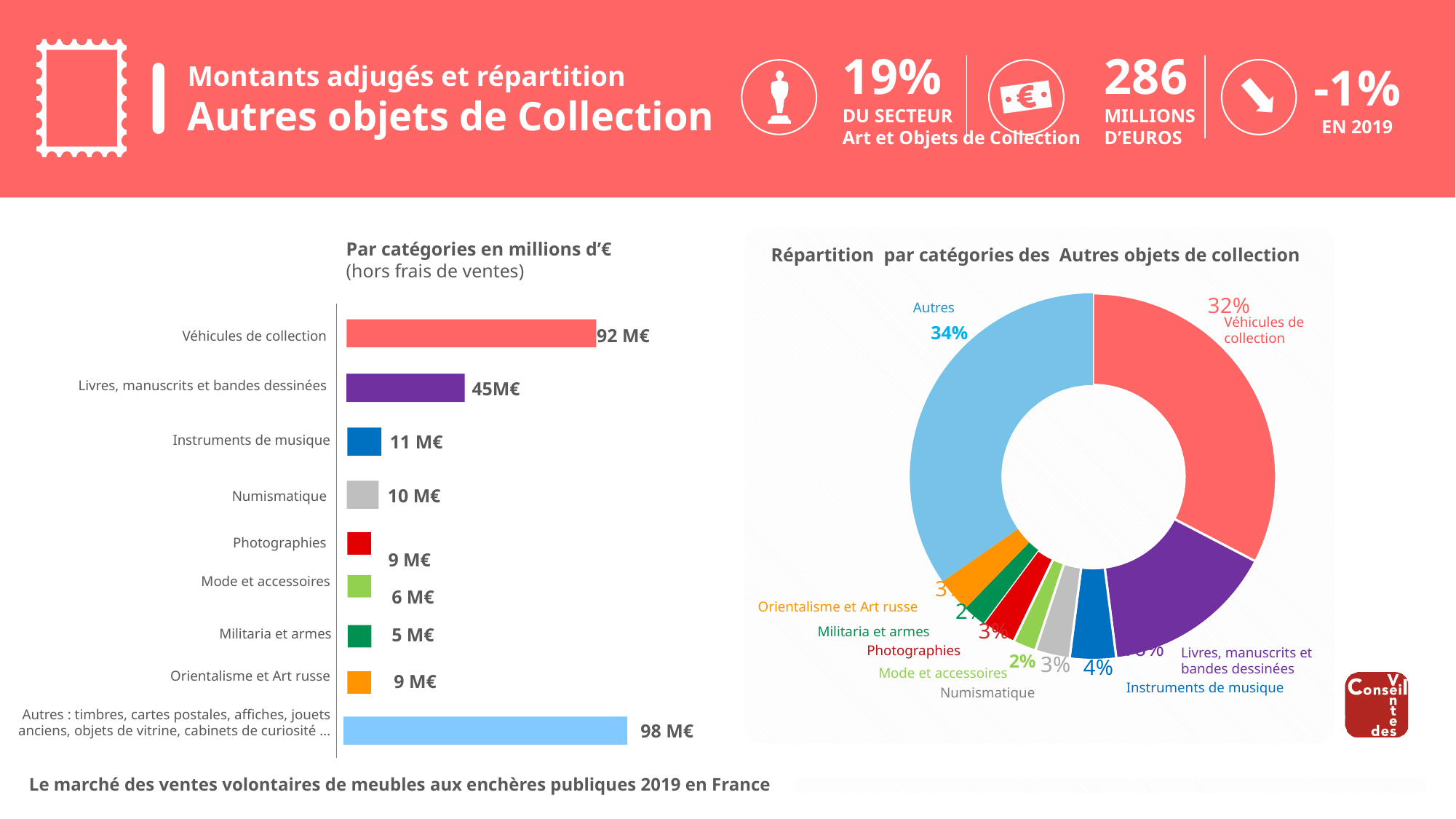
In the bar chart 'Par catégories en millions d'€', what is the value for Livres, manuscrits et bandes dessinées? 45M€ In the donut chart 'Répartition par catégories des Autres objets de collection', what share does Instruments de musique have? 4% How many categories are shown in the bar chart 'Par catégories en millions d'€'? 9 In the donut chart 'Répartition par catégories des Autres objets de collection', what share does Véhicules de collection have? 32% In the bar chart 'Par catégories en millions d'€', what is the difference between Véhicules de collection and Livres, manuscrits et bandes dessinées? 47 M€ In the bar chart 'Par catégories en millions d'€', what is the value for Numismatique? 10 M€ What type of chart is the chart on the left of the slide? Bar chart In the donut chart 'Répartition par catégories des Autres objets de collection', what share does Autres have? 34% In the bar chart 'Par catégories en millions d'€', which category has the lowest value? Militaria et armes In the bar chart 'Par catégories en millions d'€', which is larger: Instruments de musique or Mode et accessoires? Instruments de musique In the bar chart 'Par catégories en millions d'€', which category has the highest value? Autres In the bar chart 'Par catégories en millions d'€', what is the value for Véhicules de collection? 92 M€